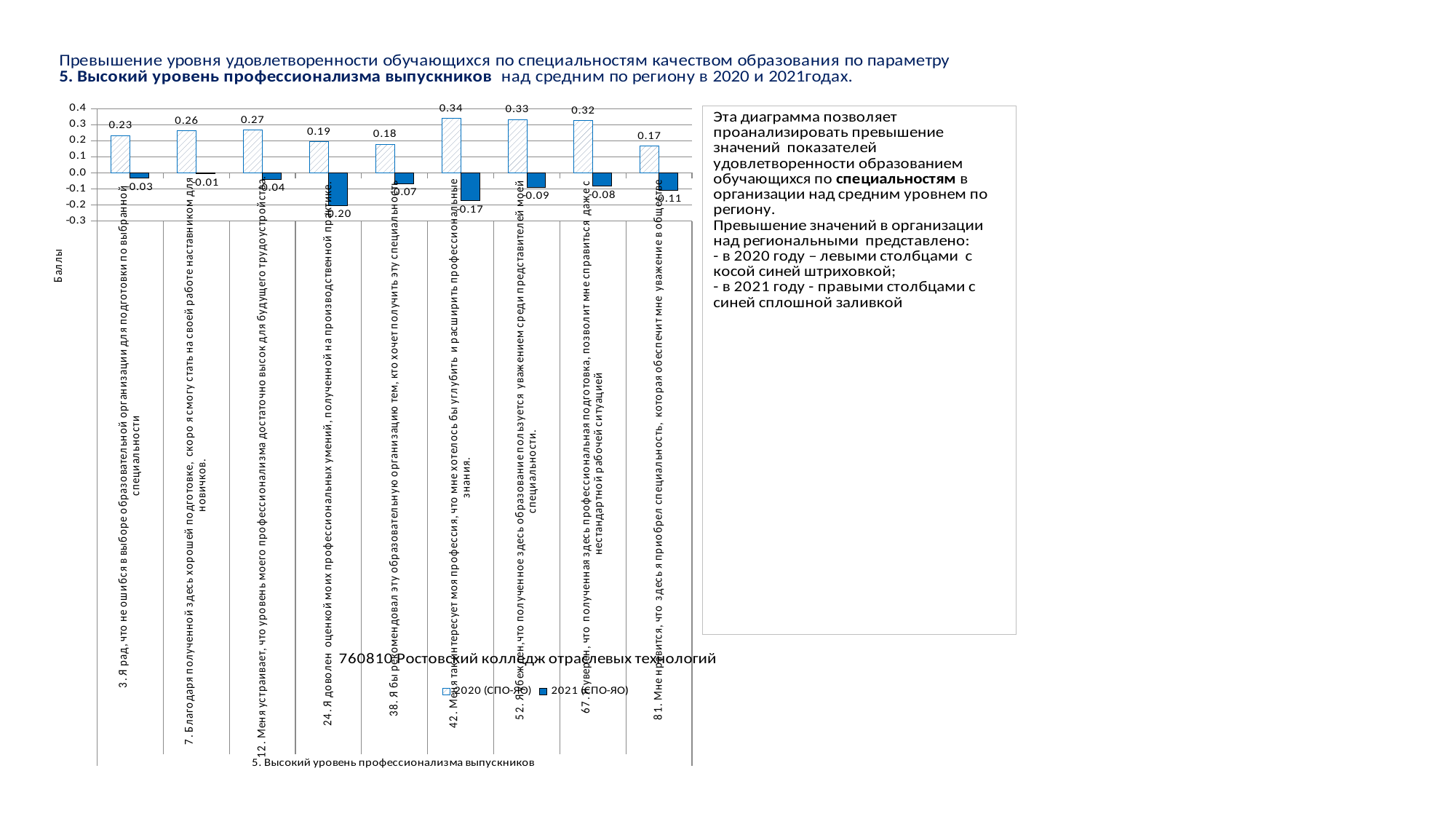
Which statement has the lowest 2021 (СПО-ЯО) value? 24. Я доволен оценкой моих профессиональных умений, полученной на производственной практике. How many series does the chart legend list? 2 What is the 2021 (СПО-ЯО) value for statement 24 ("Я доволен оценкой моих профессиональных умений...")? -0.20 What is the difference between the 2020 (СПО-ЯО) values for statement 42 and statement 81? 0.17 What is the 2021 (СПО-ЯО) value for statement 7 ("Благодаря полученной здесь хорошей подготовке...")? -0.01 Is the 2020 (СПО-ЯО) value for statement 52 greater or less than 0.3? greater Which statement has the highest 2020 (СПО-ЯО) value? 42. Меня так интересует моя профессия, что мне хотелось бы углубить и расширить профессиональные знания. Which is larger: the 2020 (СПО-ЯО) value for statement 7 or for statement 38? statement 7 What is the label of the vertical axis of the chart? Баллы How many categories (statements) are plotted on the chart? 9 What type of chart is shown on the slide? bar chart What is the 2020 (СПО-ЯО) value for statement 3 ("Я рад, что не ошибся в выборе образовательной организации...")? 0.23